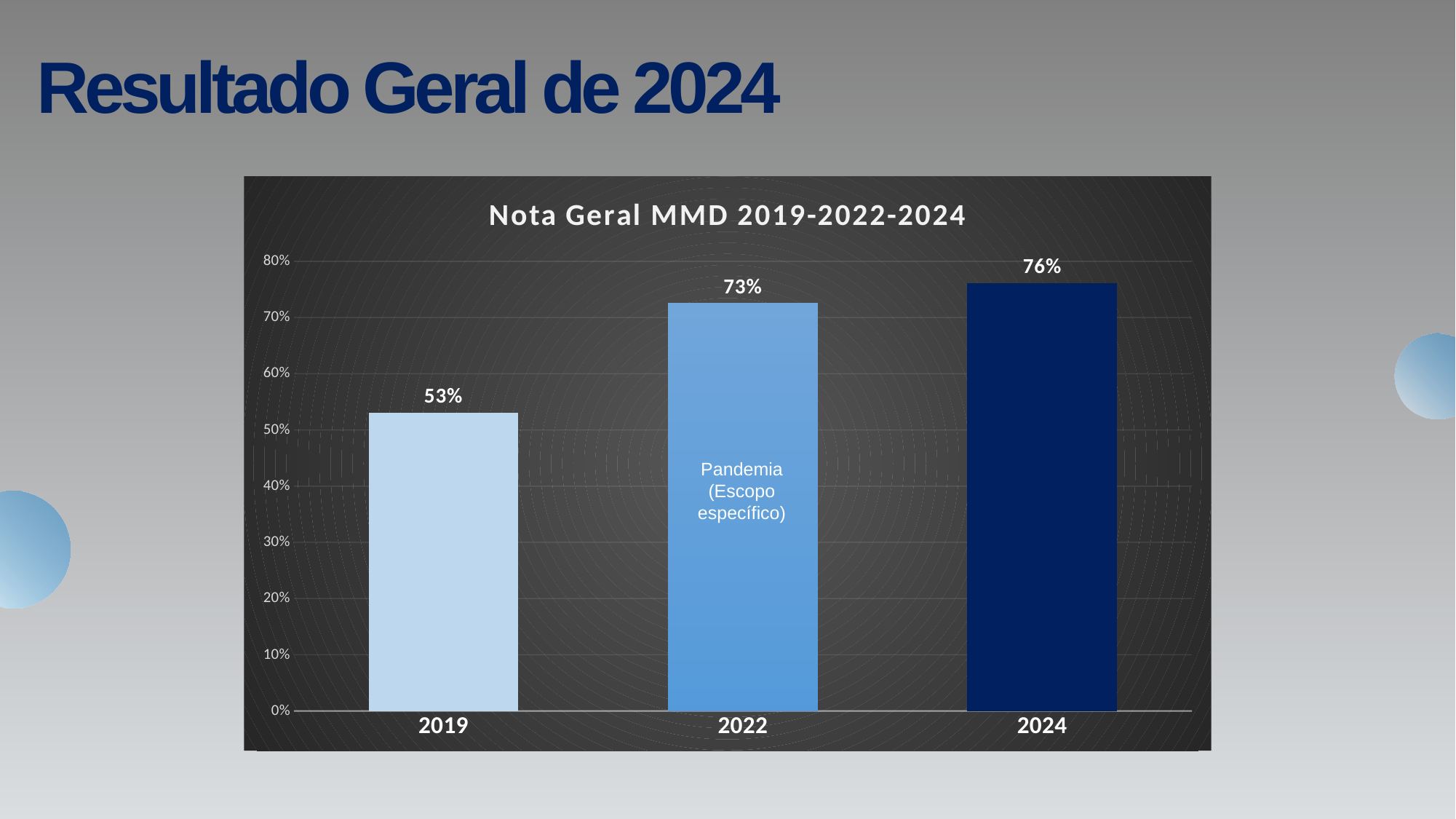
Which year has the highest value? 2024 Do the values rise or fall from 2019 to 2024? rise What is the difference between the values for 2022 and 2019? 20% Which year has the lowest value? 2019 Which is larger, the value for 2019 or the value for 2022? 2022 What is the value for 2019? 53% Is the value for 2019 greater or less than 60%? less What is the difference between the values for 2024 and 2019? 23% What is the value for 2022? 73% What is the value for 2024? 76% How many years are shown on the chart? 3 What kind of chart is shown? bar chart